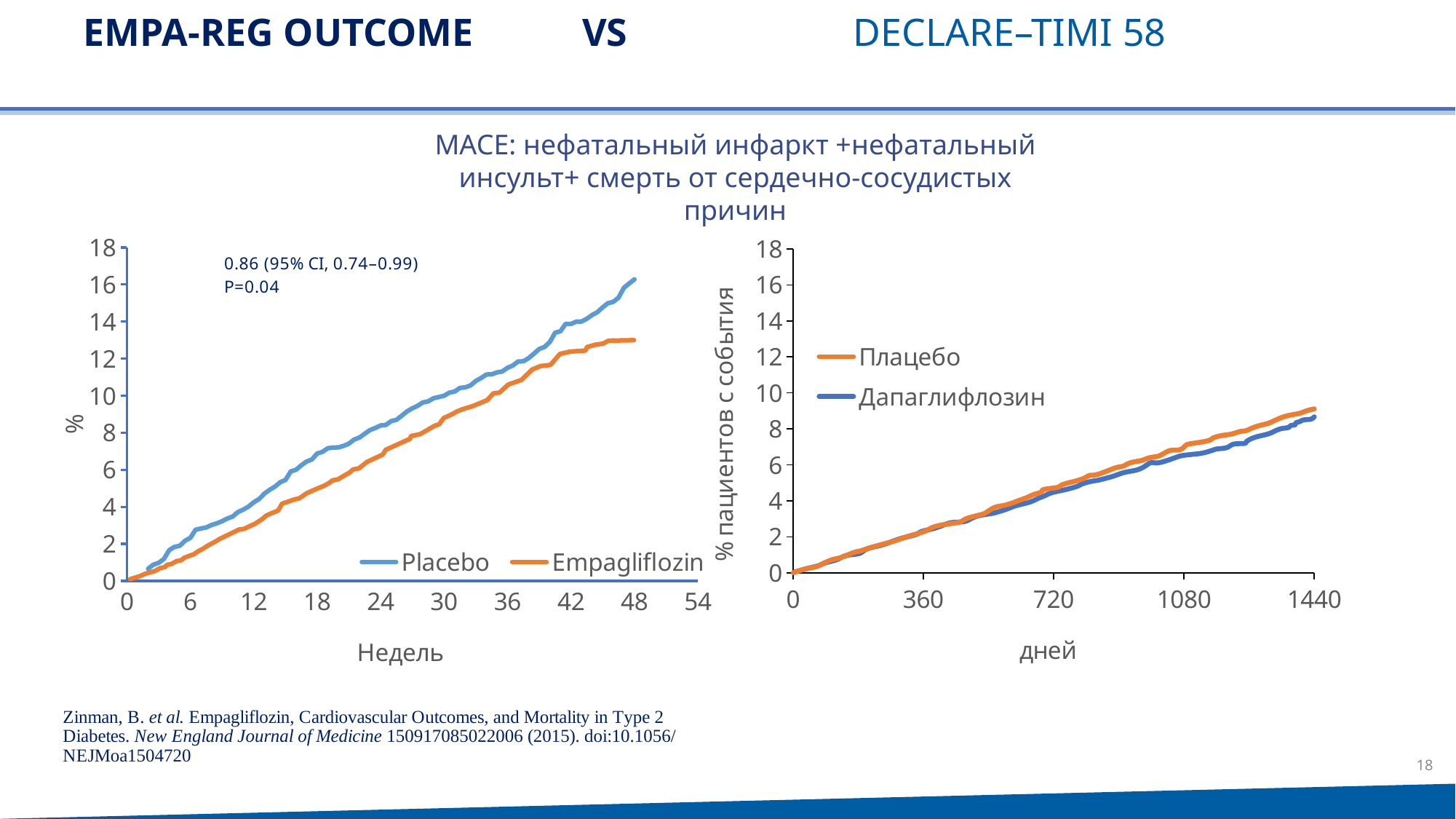
What kind of chart is the EMPA-REG OUTCOME chart on the left? line chart How many series does the legend of the DECLARE–TIMI 58 chart on the right list? 2 What hazard ratio and confidence interval are printed on the EMPA-REG OUTCOME chart on the left? 0.86 (95% CI, 0.74–0.99) In the EMPA-REG OUTCOME chart on the left, is the value for Placebo at week 48 greater or less than 14? greater In the DECLARE–TIMI 58 chart on the right, is the value for Дапаглифлозин at 720 days greater or less than 6? less What is the x-axis label of the DECLARE–TIMI 58 chart on the right? дней How many series does the legend of the EMPA-REG OUTCOME chart on the left list? 2 In the EMPA-REG OUTCOME chart on the left, is the value for Empagliflozin at week 48 greater or less than 14? less In the EMPA-REG OUTCOME chart on the left, which series is higher at week 24, Placebo or Empagliflozin? Placebo In the DECLARE–TIMI 58 chart on the right, do the values for Дапаглифлозин rise or fall along the x axis? rise In the EMPA-REG OUTCOME chart on the left, do the values for Placebo rise or fall as the weeks increase? rise